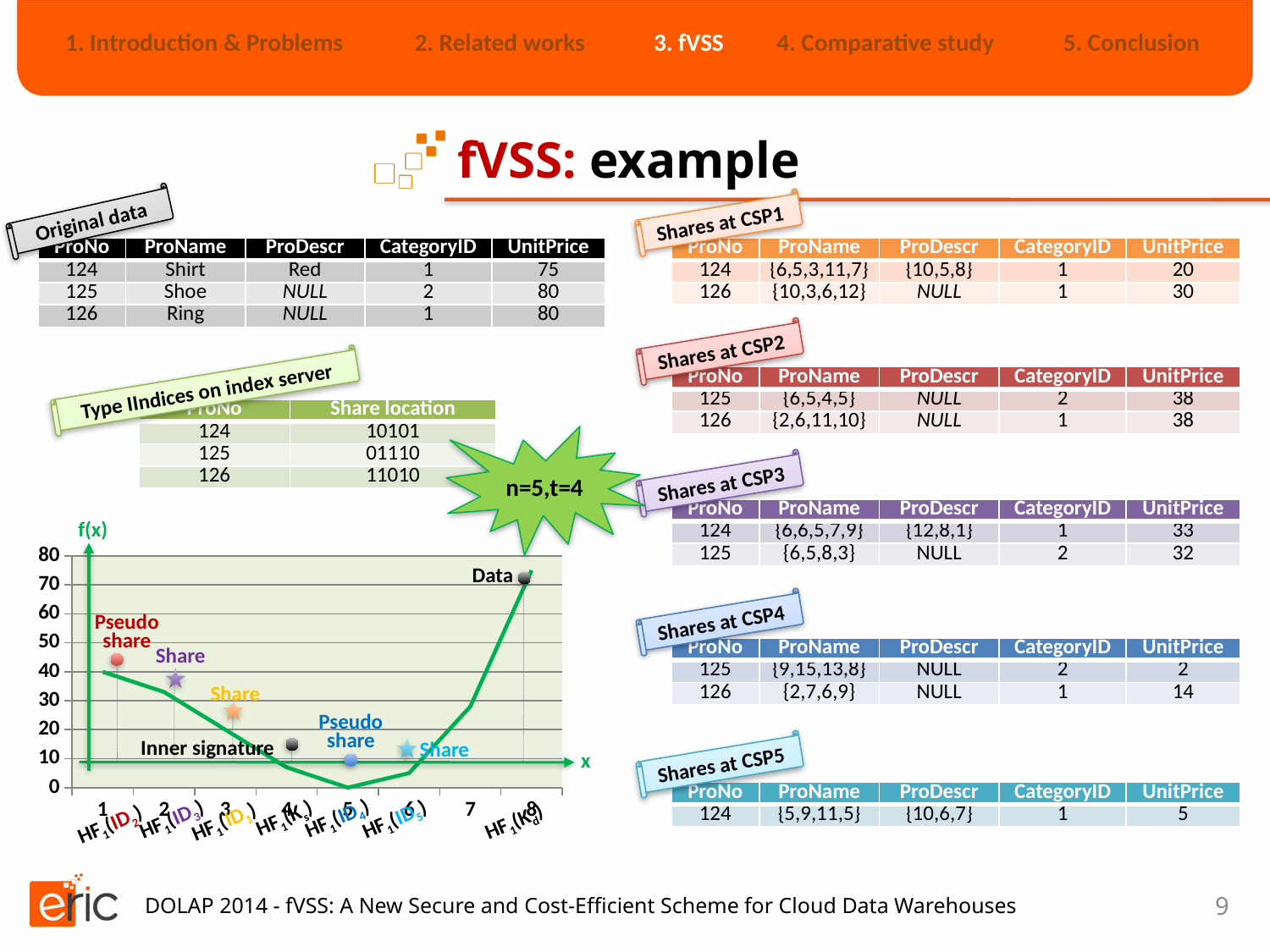
What is the label on the vertical axis of the chart? f(x) What kind of chart is shown on the slide? line chart Which labelled point on the chart has the highest f(x) value? Data Which has the larger f(x) value: the point labelled Data or the red point labelled Pseudo share? Data Is the f(x) value of the point labelled Data greater or less than 60? greater Is the f(x) value of the point labelled Inner signature greater or less than 20? less What is the highest value shown on the vertical axis of the chart? 80 Is the f(x) value of the red point labelled Pseudo share greater or less than 30? greater Between x = 6 and x = 8, does the curve on the chart rise or fall? rise How many labelled points are marked on the curve in the chart? 7